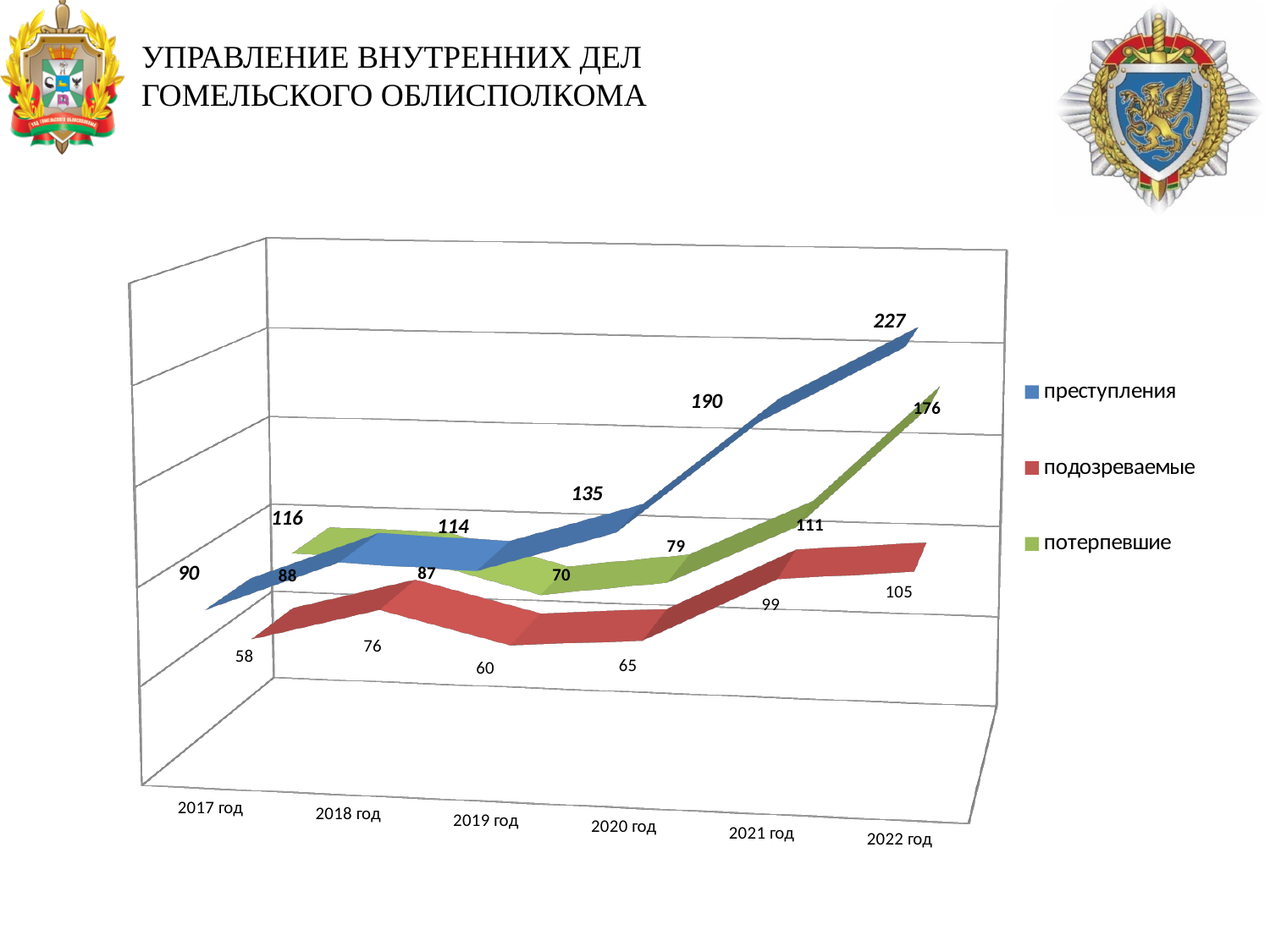
In which year is the value for подозреваемые lowest? 2017 год Does the value for преступления rise or fall from 2020 год to 2022 год? rise What is the value for подозреваемые in 2019 год? 60 How many years are shown on the x axis? 6 What is the value for преступления in 2022 год? 227 What kind of chart is shown on the slide? line chart In which year is the value for преступления highest? 2022 год What is the value for потерпевшие in 2021 год? 111 Which is larger in 2021 год: преступления or потерпевшие? преступления How many series does the legend list? 3 What is the difference between преступления and потерпевшие in 2022 год? 51 What is the value for преступления in 2017 год? 90